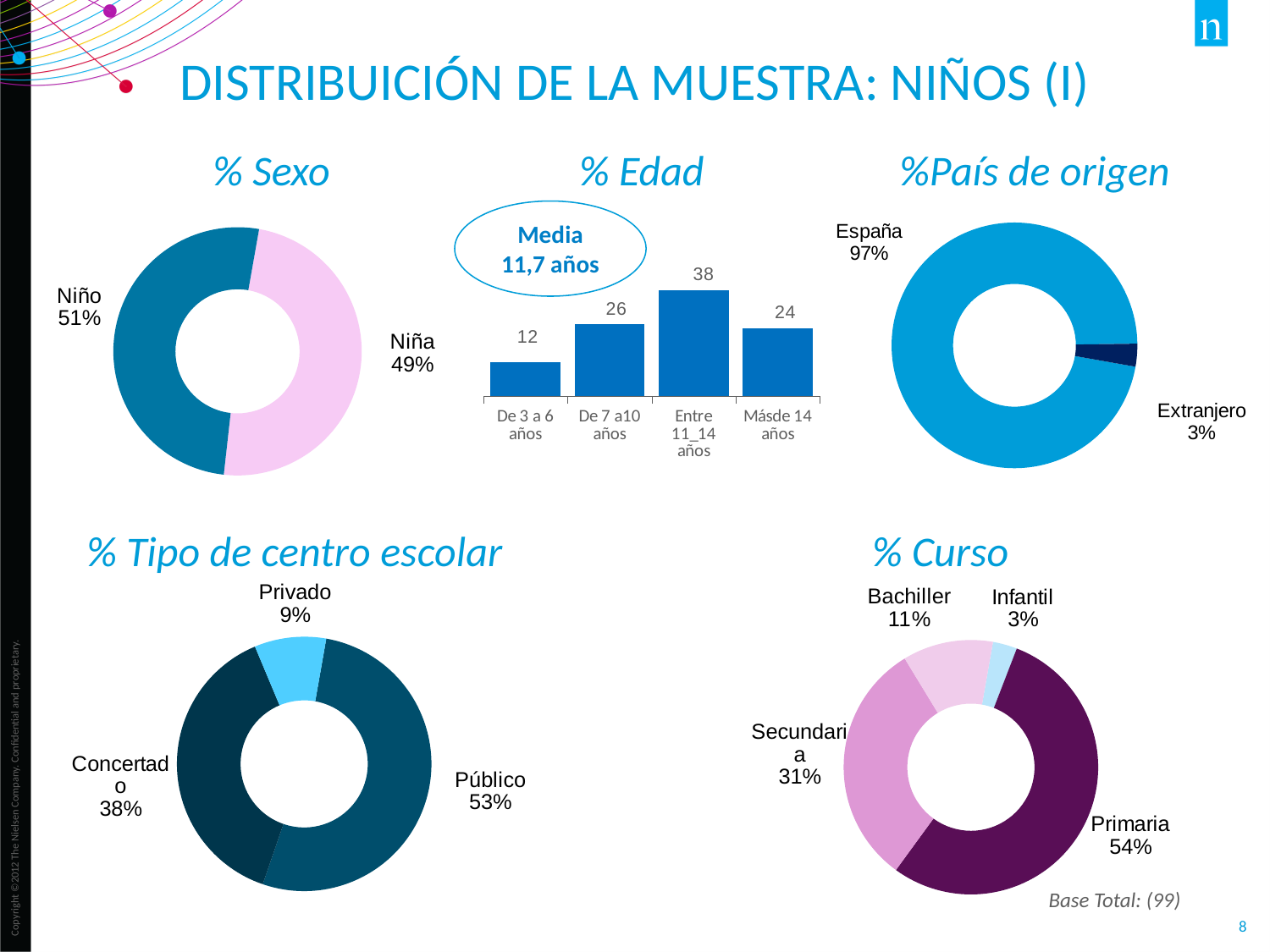
In the '% Sexo' chart, what is the value for Niño? 51% In the '% Edad' chart, what is the value for 'Entre 11_14 años'? 38 In the '% Tipo de centro escolar' chart, what is the difference between Público and Concertado? 15% What is the mean age shown in the '% Edad' chart? 11,7 años In the '% Edad' chart, what is the difference between 'Entre 11_14 años' and 'De 3 a 6 años'? 26 In the '% Curso' chart, which is larger, Secundaria or Bachiller? Secundaria In the '% Edad' chart, which age group has the lowest value? De 3 a 6 años In the '%País de origen' chart, what is the value for Extranjero? 3% In the '% Curso' chart, what is the value for Infantil? 3% In the '% Tipo de centro escolar' chart, which category has the largest share? Público What kind of chart is the '% Edad' chart? bar chart In the '% Edad' chart, how many age categories are shown? 4